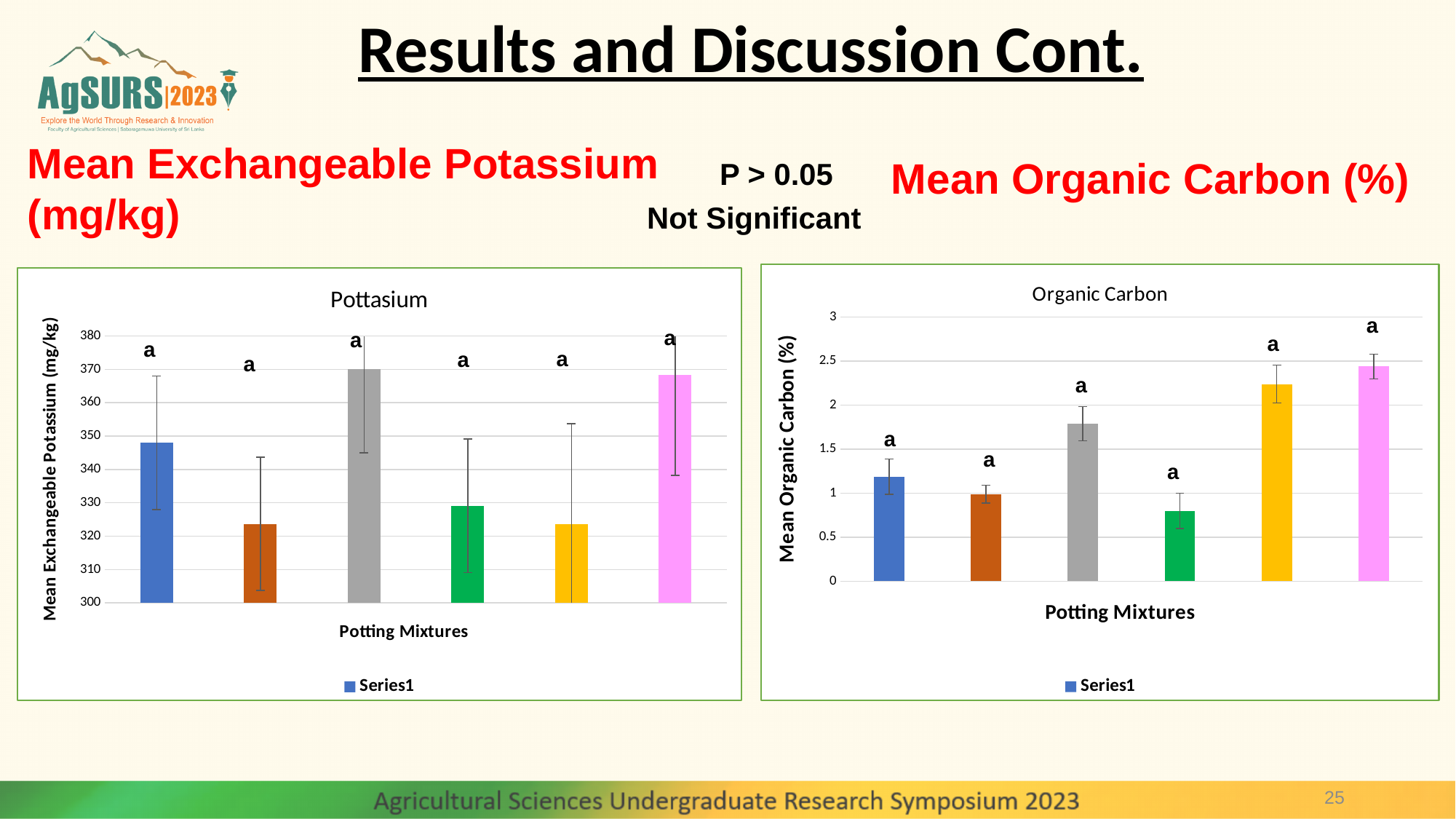
In the Organic Carbon chart, is the value for the yellow bar greater or less than 2? greater In the Pottasium chart, is the value for the blue bar greater or less than 340? greater In the Organic Carbon chart, which bar colour has the lowest value? green How many bars are plotted in the Organic Carbon chart on the right? 6 What is the y-axis title of the Organic Carbon chart? Mean Organic Carbon (%) In the Pottasium chart, is the value for the gray bar greater or less than 360? greater How many series does the legend of the Pottasium chart list? 1 What kind of chart is the Pottasium chart on the left? bar chart In the Organic Carbon chart, which bar colour has the highest value? pink In the Organic Carbon chart, which is larger, the blue bar or the orange bar? blue bar